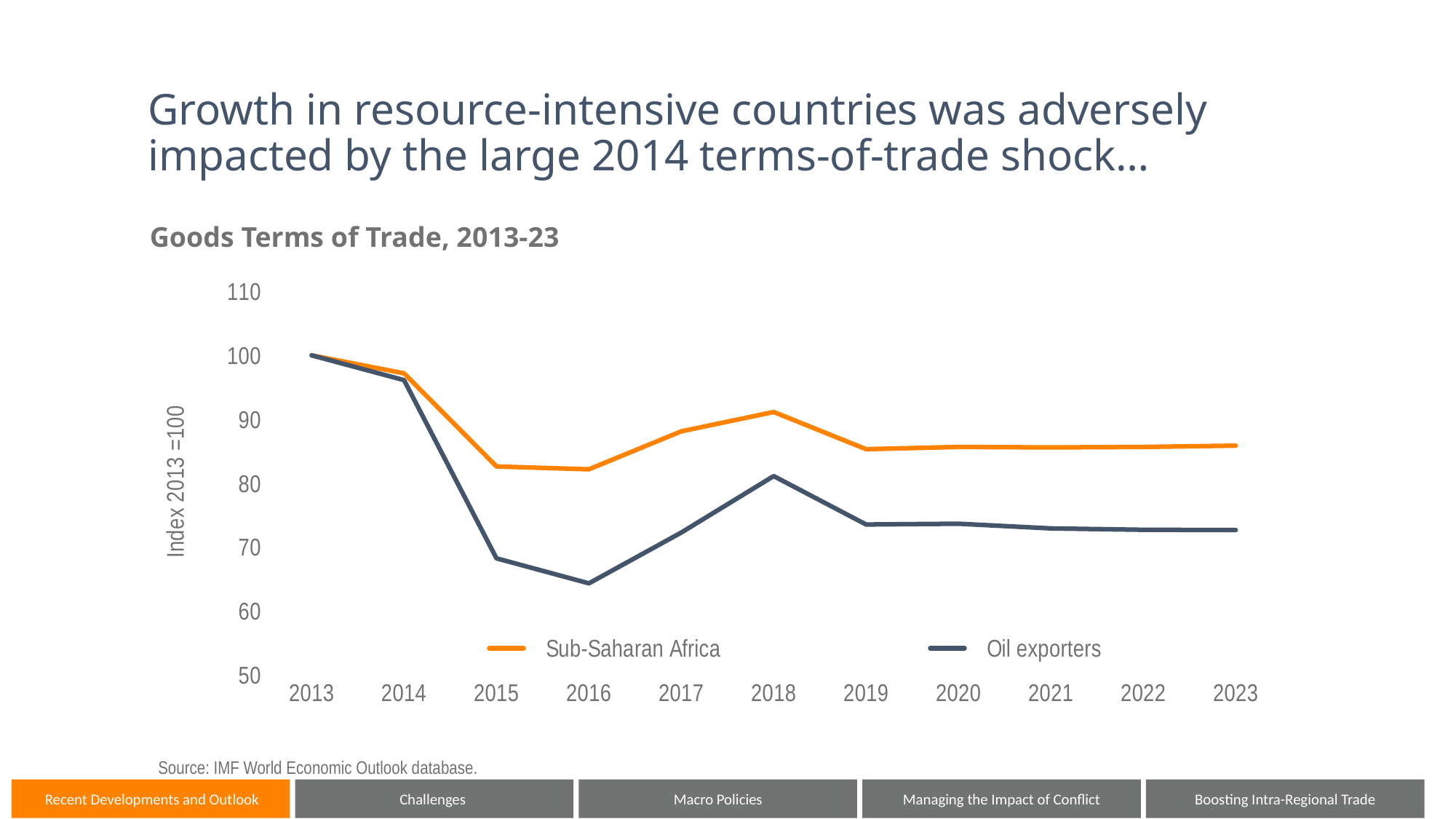
Is the value for Oil exporters in 2016 greater or less than 70? less What is the label on the y axis? Index 2013 =100 In which year is the Sub-Saharan Africa series at its highest? 2013 Is the value for Oil exporters in 2019 greater or less than 80? less Does the Oil exporters series rise or fall from 2013 to 2015? fall Is the value for Sub-Saharan Africa in 2015 greater or less than 90? less In which year is the Oil exporters series at its lowest? 2016 How many series does the legend list? 2 What is the value for Oil exporters in 2013? 100 What kind of chart is shown on the slide? line chart In 2016, which series has the larger value, Sub-Saharan Africa or Oil exporters? Sub-Saharan Africa How many years are plotted along the x axis? 11